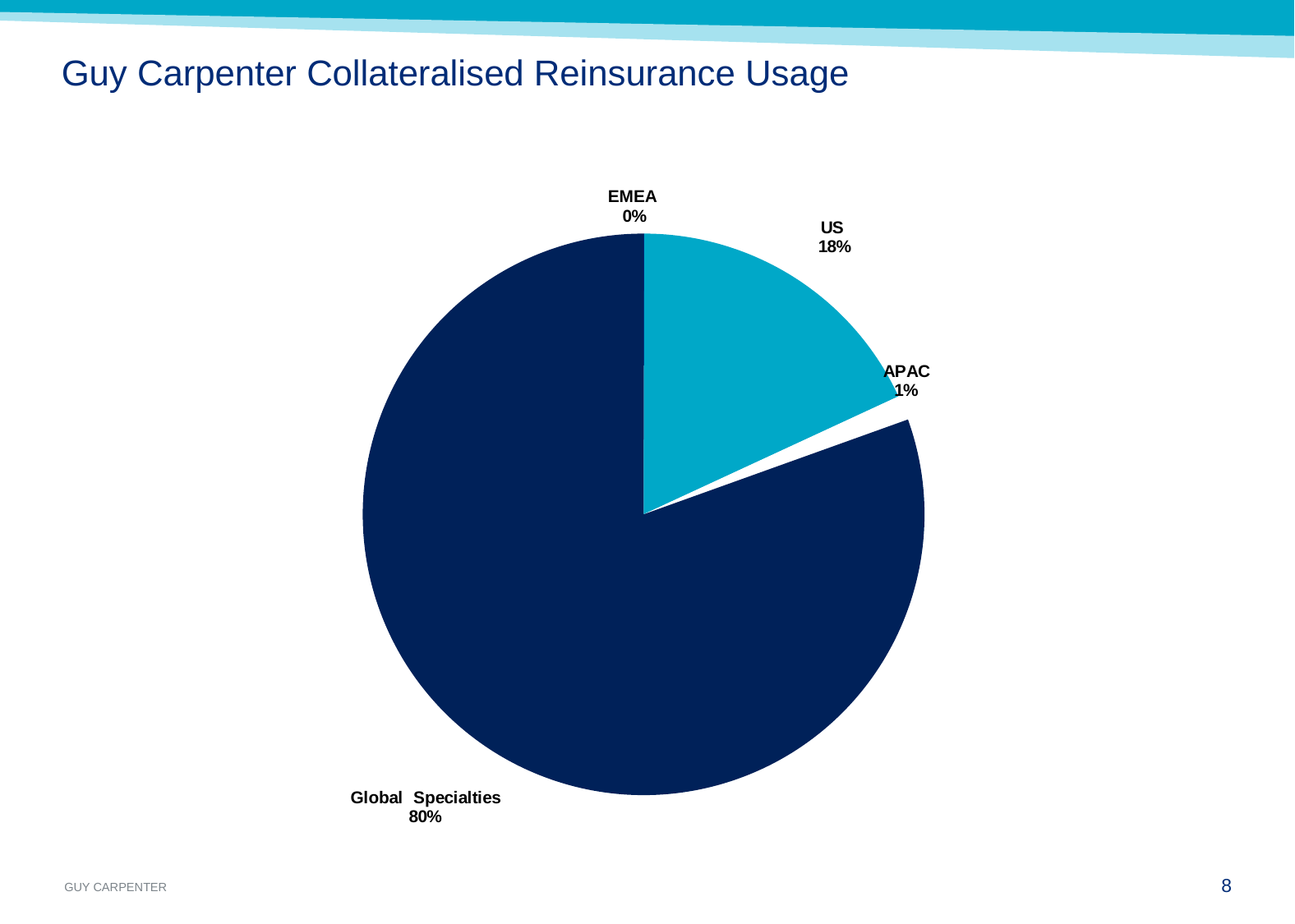
What is the title of the slide containing the pie chart? Guy Carpenter Collateralised Reinsurance Usage What is the value shown for EMEA? 0% What is the value shown for US? 18% What is the value shown for APAC? 1% What is the combined share of US and APAC? 19% What kind of chart is shown on the slide? pie chart Which category has the largest slice of the pie? Global Specialties Which category has the smallest slice of the pie? EMEA What is the difference between the Global Specialties share and the US share? 62% How many categories are labelled on the pie chart? 4 Which is larger, the US share or the APAC share? US What share of the pie does Global Specialties have? 80%